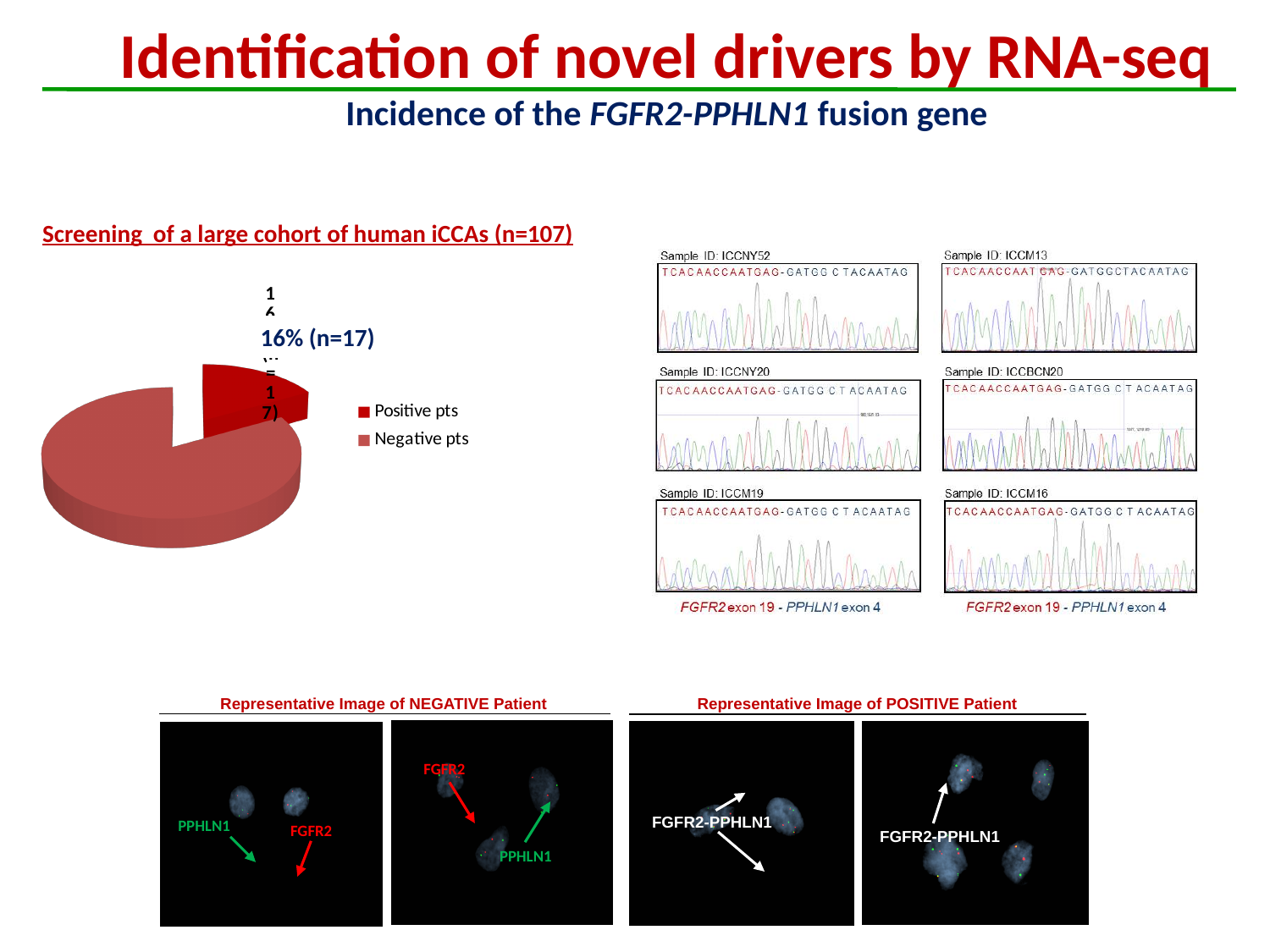
What is the heading above the pie chart? Screening of a large cohort of human iCCAs (n=107) What type of chart is shown on the left of the slide? pie chart How many patients are in the Positive pts slice of the pie chart? n=17 Is the share of Positive pts in the pie chart greater or less than 50%? less What share of the pie chart is labelled for Positive pts? 16% Which slice of the pie chart is larger, Positive pts or Negative pts? Negative pts How many entries does the pie chart's legend list? 2 Which category is the smallest slice of the pie chart? Positive pts Which legend entry of the pie chart is shown in dark red? Positive pts How many slices does the pie chart have? 2 Which category is the largest slice of the pie chart? Negative pts